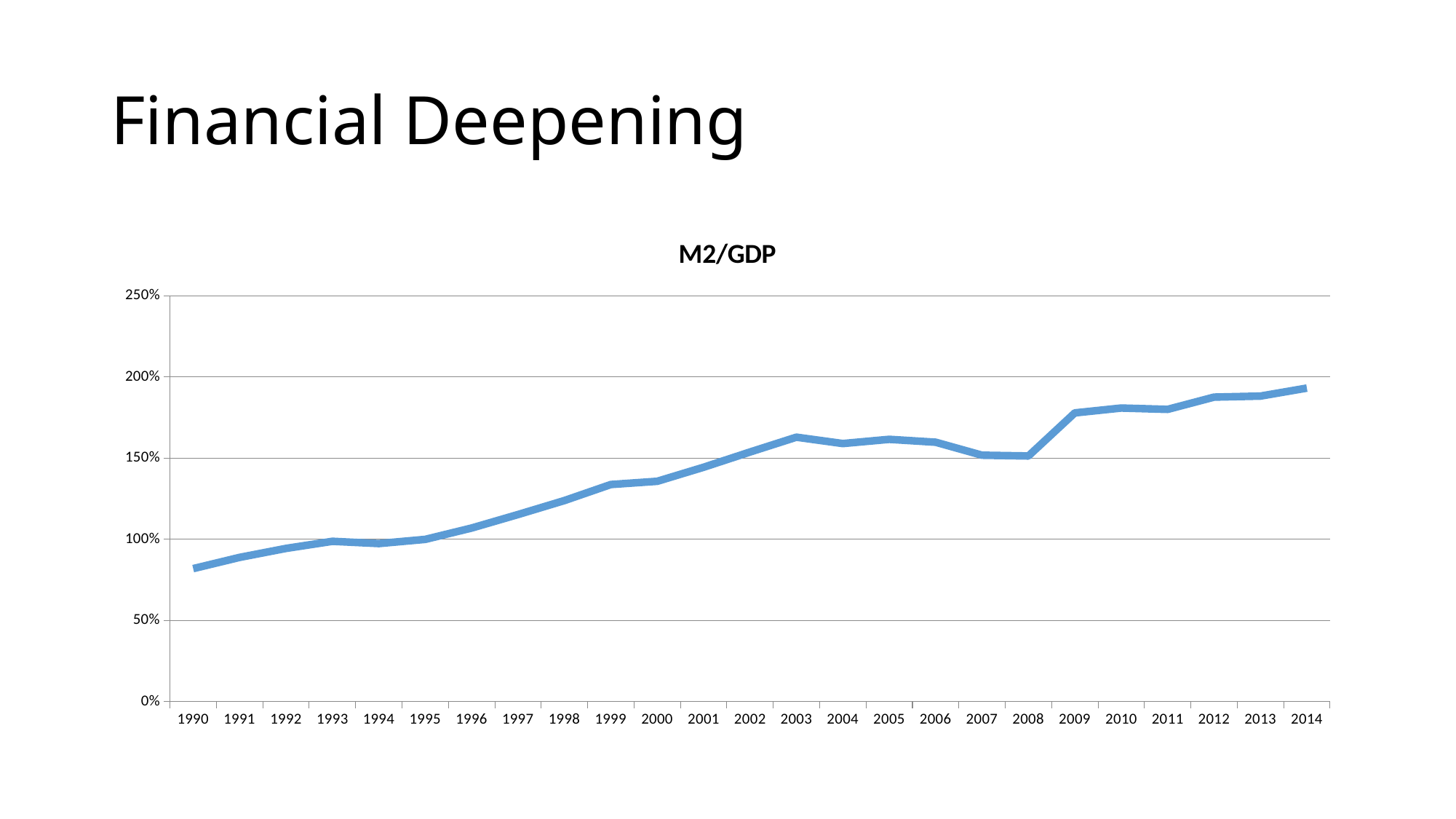
Is the M2/GDP value for 2014 greater or less than 150%? greater Is the M2/GDP value for 2009 greater or less than 150%? greater Which year has a higher M2/GDP ratio, 2008 or 2009? 2009 Which year has a higher M2/GDP ratio, 2003 or 2007? 2003 Is the M2/GDP value for 1999 greater or less than 150%? less What kind of chart is shown on the slide? Line chart How many years are plotted along the x axis of the M2/GDP chart? 25 In which year is the M2/GDP ratio highest? 2014 Does the M2/GDP ratio generally rise or fall from 1990 to 2014? Rise What is the title of the chart? M2/GDP In which year is the M2/GDP ratio lowest? 1990